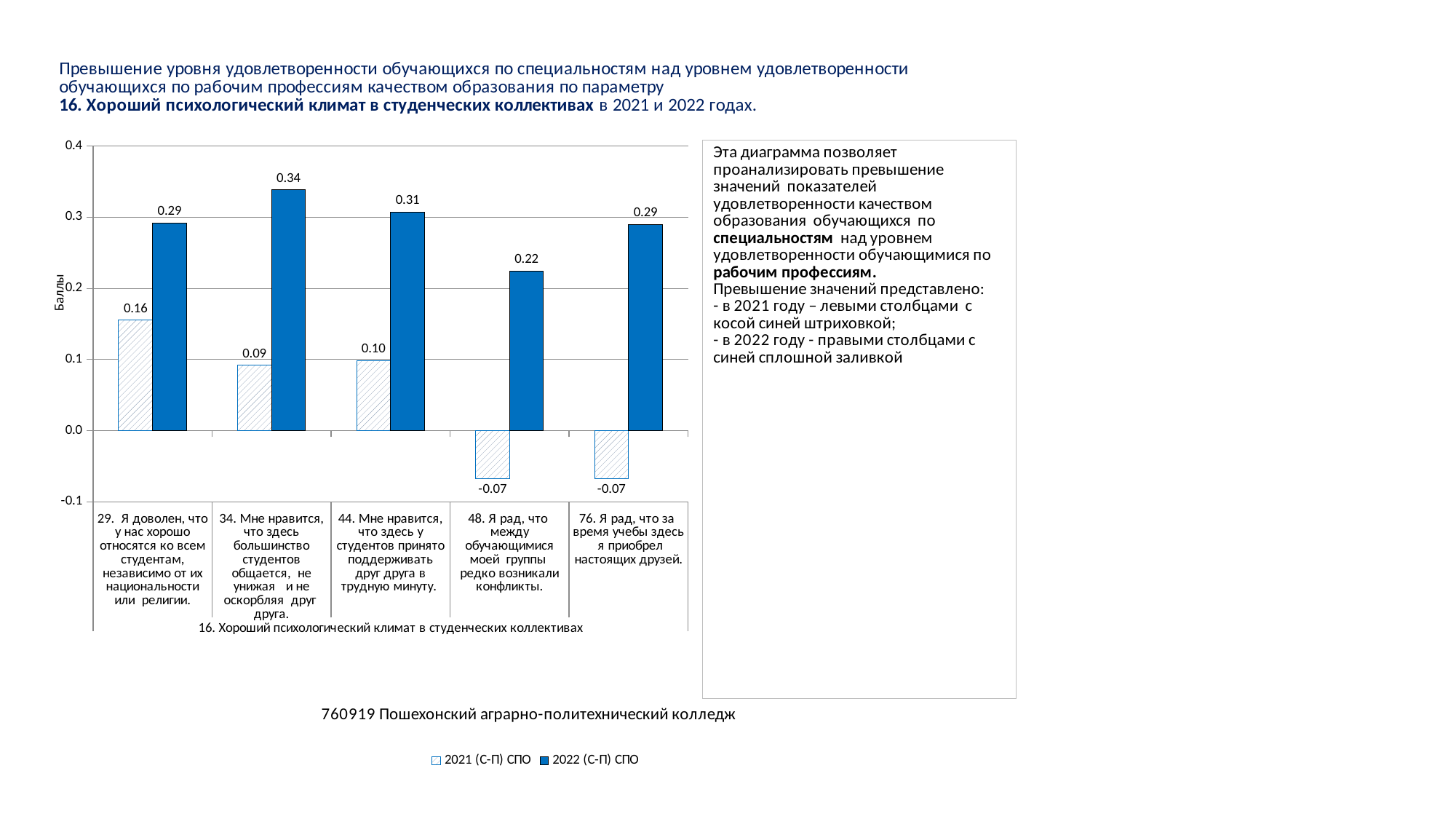
What is the label of the y axis? Баллы What is the 2021 (С-П) СПО value for statement 29 (Я доволен, что у нас хорошо относятся ко всем студентам, независимо от их национальности или религии)? 0.16 What is the 2021 (С-П) СПО value for statement 48 (Я рад, что между обучающимися моей группы редко возникали конфликты)? -0.07 Which statement has the highest 2022 (С-П) СПО value? 34. Мне нравится, что здесь большинство студентов общается, не унижая и не оскорбляя друг друга. Which statement has the lowest 2022 (С-П) СПО value? 48. Я рад, что между обучающимися моей группы редко возникали конфликты. Is the 2022 (С-П) СПО value for statement 48 greater or less than 0.3? less What is the difference between the 2022 and 2021 values for statement 44 (Мне нравится, что здесь у студентов принято поддерживать друг друга в трудную минуту)? 0.21 How many categories (statements) are shown on the x axis? 5 What is the 2022 (С-П) СПО value for statement 34 (Мне нравится, что здесь большинство студентов общается, не унижая и не оскорбляя друг друга)? 0.34 How many series does the legend list? 2 For statement 76 (Я рад, что за время учебы здесь я приобрел настоящих друзей), which series has the larger value: 2021 (С-П) СПО or 2022 (С-П) СПО? 2022 (С-П) СПО What type of chart is shown on the slide? Bar chart